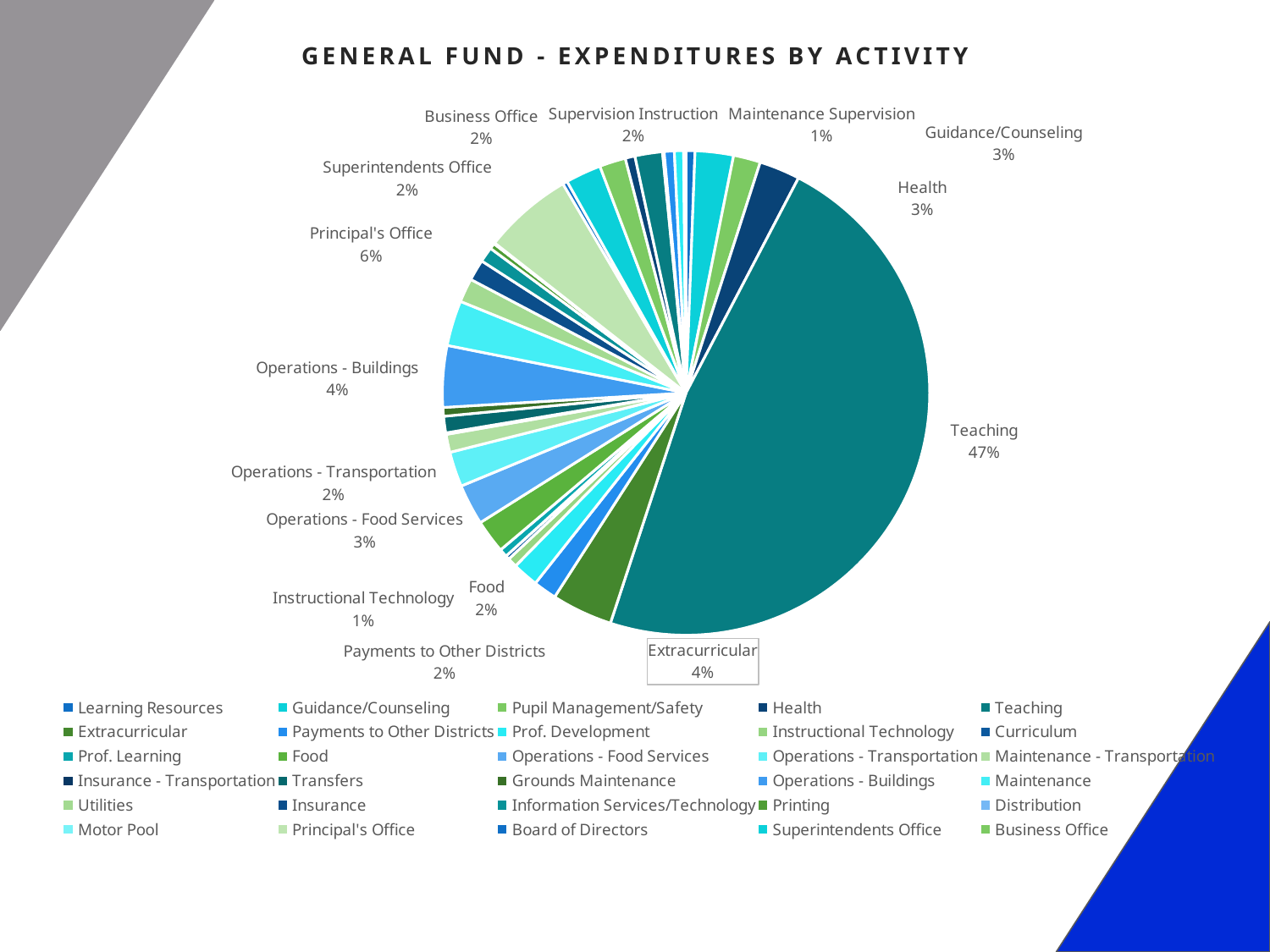
What percentage is labelled for Operations - Buildings? 4% Which is larger, Guidance/Counseling or Business Office? Guidance/Counseling What is the difference in percentage points between Teaching and Principal's Office? 41 percentage points What share of general fund expenditures goes to Teaching? 47% What is the title of the chart? GENERAL FUND - EXPENDITURES BY ACTIVITY What percentage is shown for Maintenance Supervision? 1% Which activity has the largest slice of the pie? Teaching What is the difference in percentage points between Operations - Buildings and Operations - Transportation? 2 percentage points Which is larger, the Extracurricular slice or the Health slice? Extracurricular What percentage is labelled for Principal's Office? 6% What kind of chart is shown on the slide? Pie chart How many activities are listed in the legend? 30